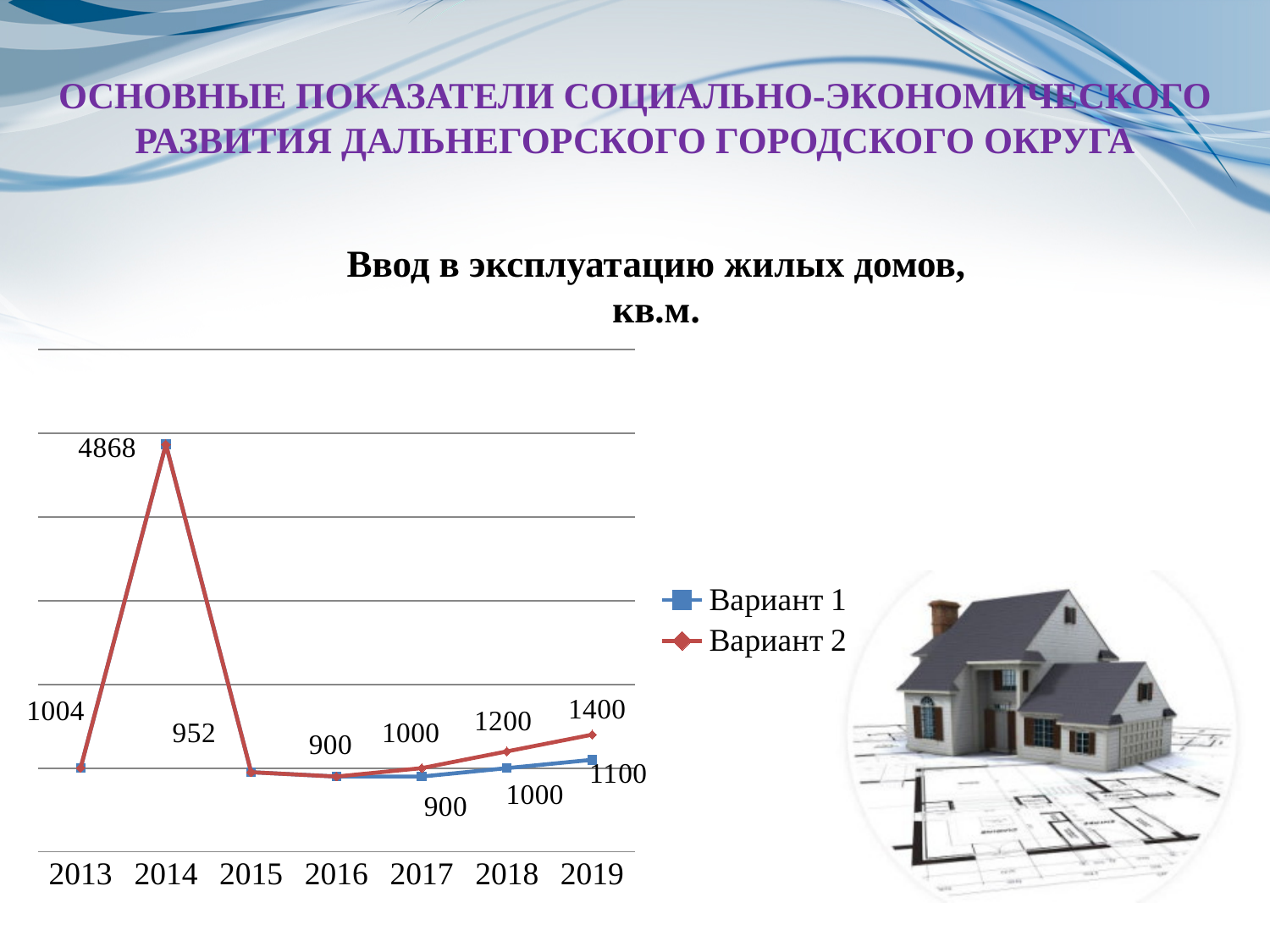
Which year has the highest value? 2014 What is the difference between the values for 2014 and 2015? 3916 What is the value for 2014? 4868 What kind of chart is shown on the slide? line chart What is the value for Вариант 2 in 2019? 1400 What is the value for Вариант 1 in 2019? 1100 Does the Вариант 2 line rise or fall from 2016 to 2019? rise What is the difference between Вариант 2 and Вариант 1 in 2019? 300 How many series does the legend list? 2 Which series has the larger value in 2018, Вариант 1 or Вариант 2? Вариант 2 How many years are shown on the x axis? 7 What is the value for 2013? 1004